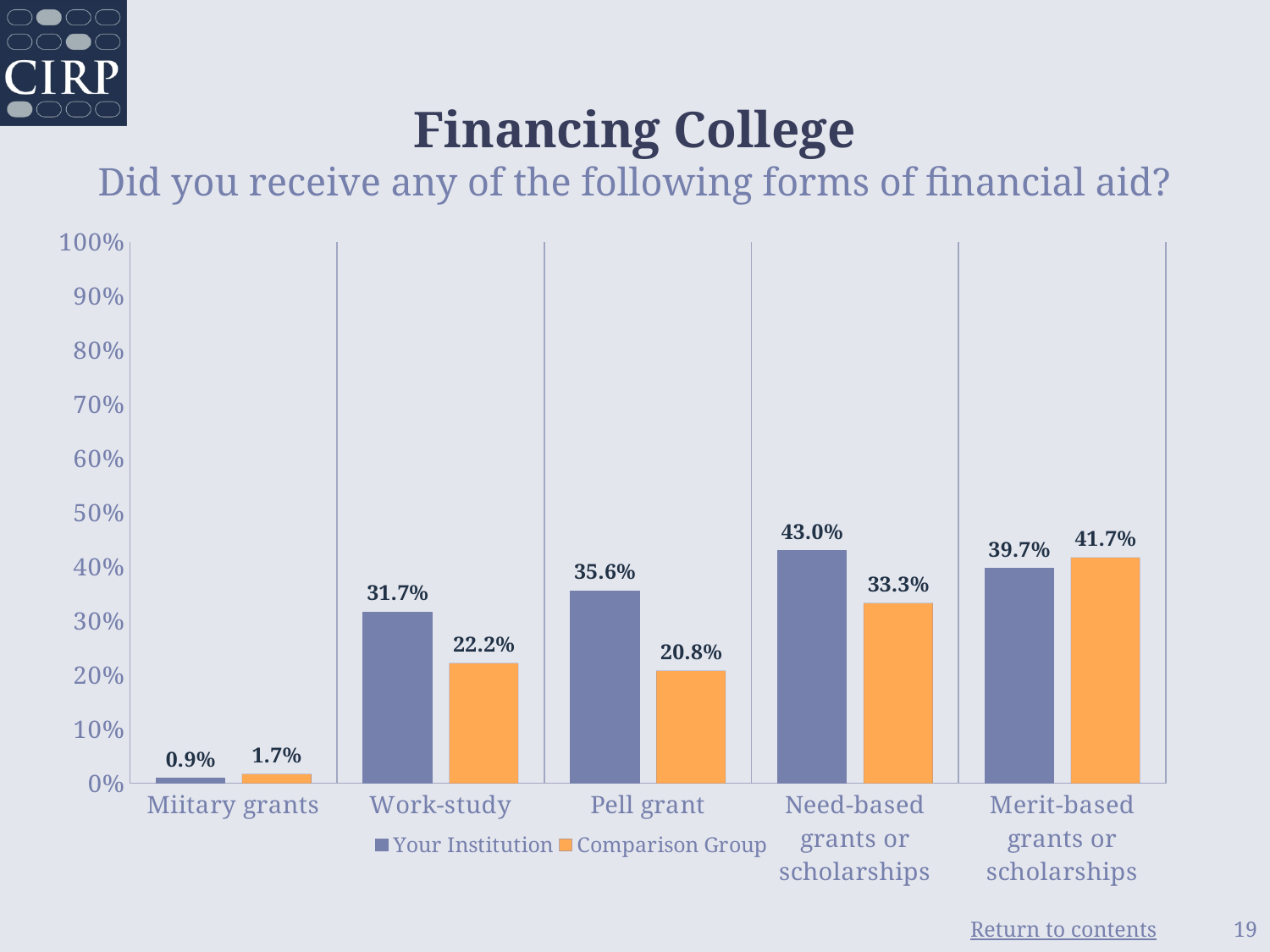
How many series does the legend list? 2 What is the Your Institution value for Military grants? 0.9% What is the Comparison Group value for Work-study? 22.2% How many financial aid categories are shown on the x axis? 5 Is the Comparison Group value for Need-based grants or scholarships greater or less than 30%? greater Which category has the lowest value for the Comparison Group? Military grants What is the title of the chart? Financing College For Merit-based grants or scholarships, which is larger: Your Institution or the Comparison Group? Comparison Group What is the difference between Your Institution and the Comparison Group for Pell grant? 14.8% What percentage of Your Institution students received a Pell grant? 35.6% What kind of chart is shown on the slide? Bar chart Which category has the highest value for Your Institution? Need-based grants or scholarships